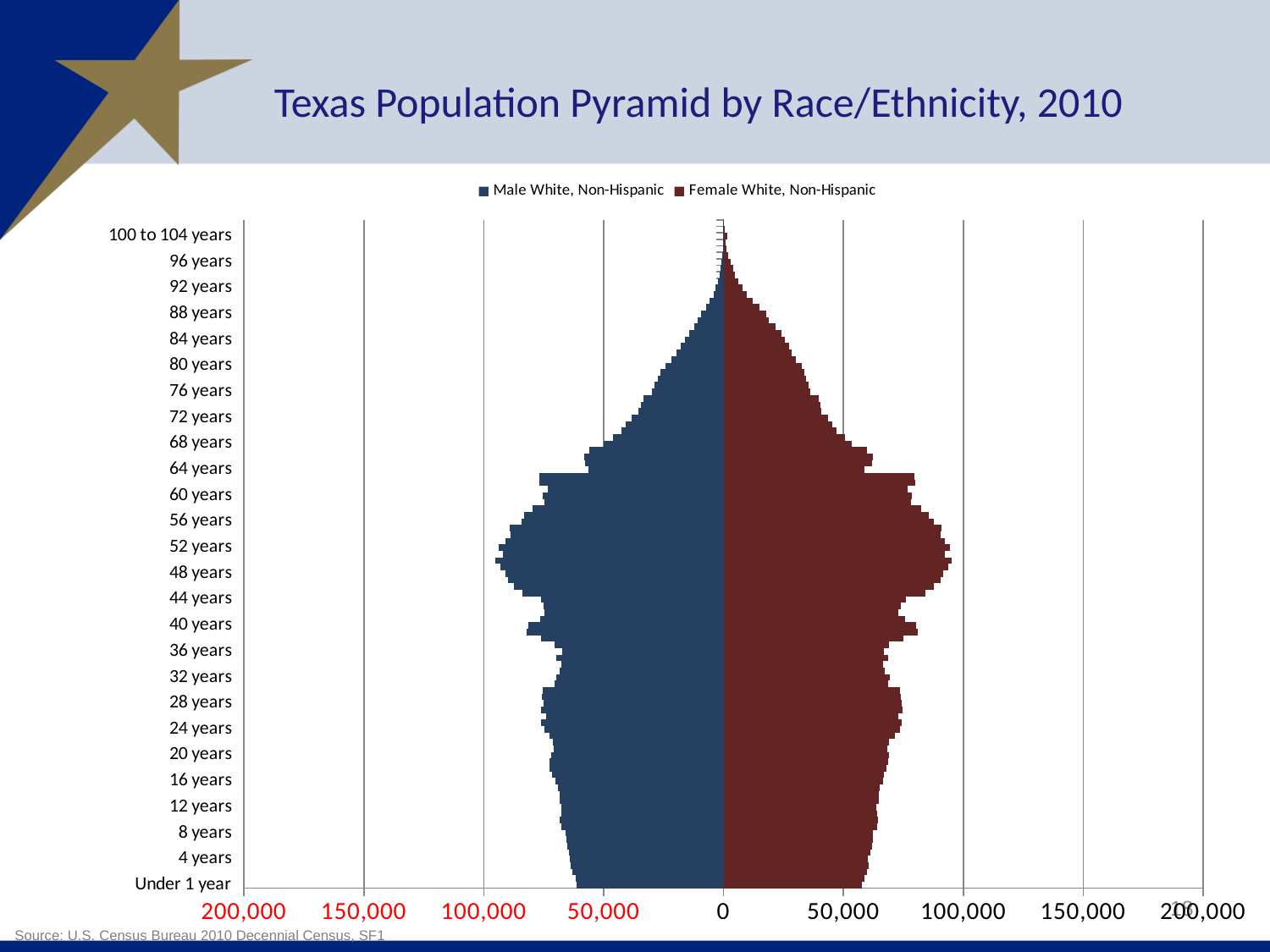
For Female White, Non-Hispanic, which is larger: the value at 52 years or the value at 80 years? 52 years What is the title of the chart? Texas Population Pyramid by Race/Ethnicity, 2010 Is the value for Female White, Non-Hispanic at 80 years greater or less than 50,000? less What kind of chart is shown on the slide? bar chart Which series is shown in dark red on the right side of the pyramid? Female White, Non-Hispanic For Male White, Non-Hispanic, which is larger: the value at 20 years or the value at 88 years? 20 years Is the value for Male White, Non-Hispanic at 88 years greater or less than 50,000? less Is the value for Male White, Non-Hispanic at 20 years greater or less than 50,000? greater Do the Female White, Non-Hispanic values rise or fall as age increases from 52 years to 100 to 104 years? fall How many series does the legend list? 2